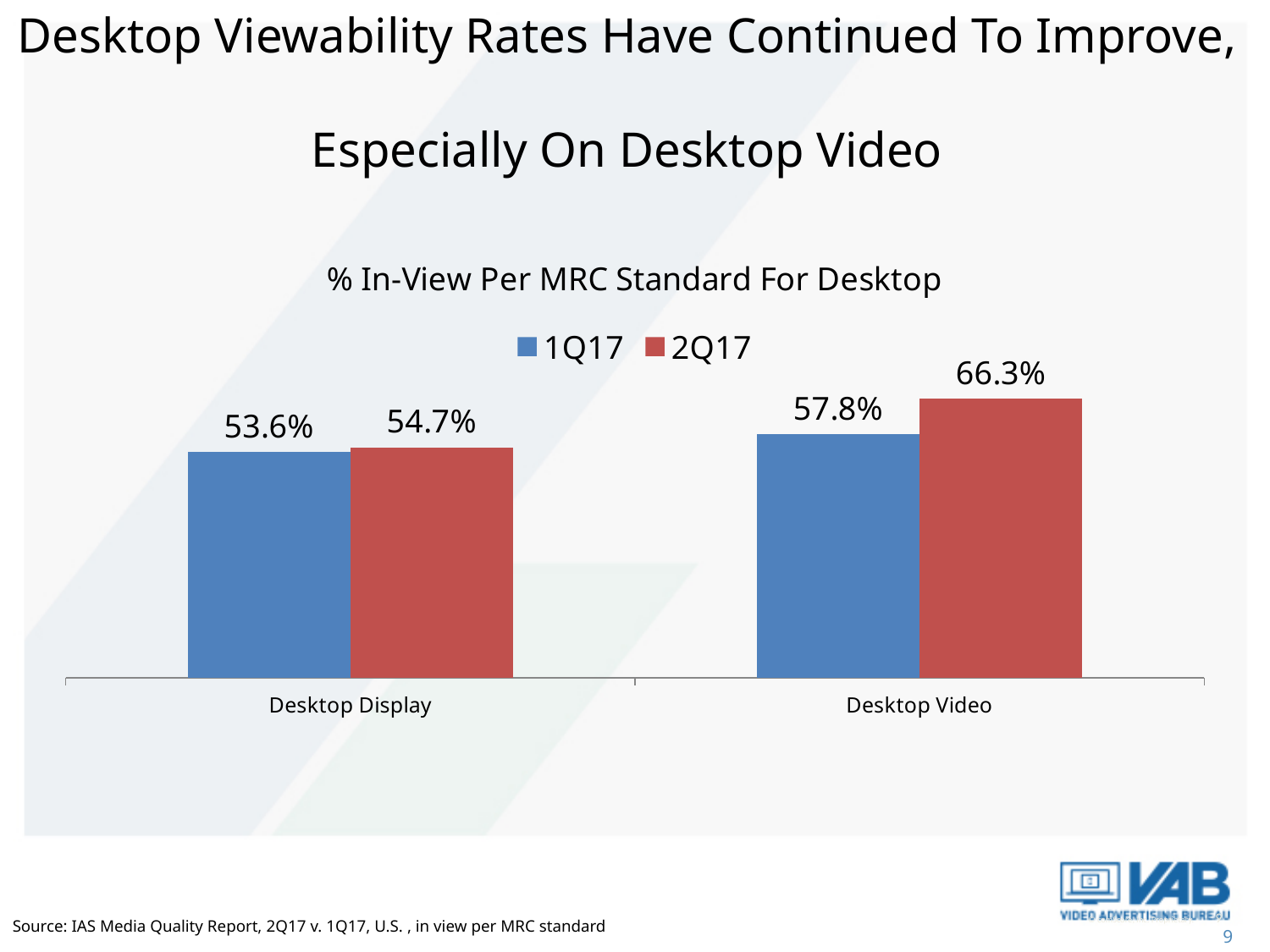
What is the 1Q17 value for Desktop Video? 57.8% What is the 2Q17 value for Desktop Display? 54.7% What is the 1Q17 value for Desktop Display? 53.6% What is the 2Q17 value for Desktop Video? 66.3% Which category has the highest 2Q17 value? Desktop Video Which category has the lowest 1Q17 value? Desktop Display Which is larger: the 2Q17 value for Desktop Display or the 1Q17 value for Desktop Video? 1Q17 value for Desktop Video How many categories are shown on the x axis? 2 What type of chart is shown on the slide? Bar chart What is the difference between the 2Q17 and 1Q17 values for Desktop Display? 1.1 percentage points What is the difference between the 2Q17 and 1Q17 values for Desktop Video? 8.5 percentage points How many series does the legend list? 2